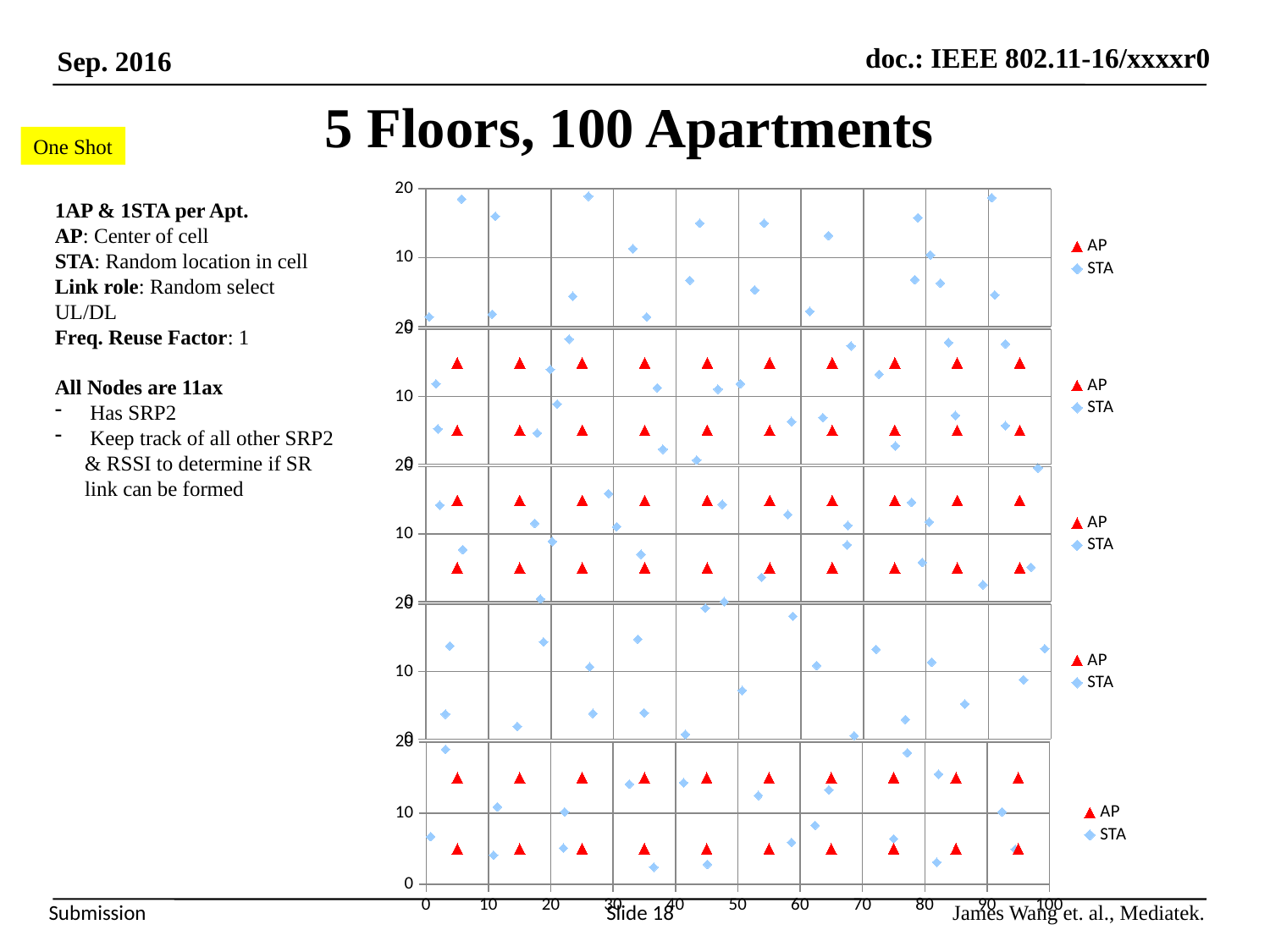
Which series is drawn with red triangle markers? AP In the middle chart, is the y value of the lower row of AP markers greater or less than 10? less What are the two series named in the legend of the top chart? AP and STA What kind of chart is used on this slide? scatter chart In the bottom chart, is the y value of the lower row of AP markers greater or less than 10? less In the bottom chart, is the y value of the upper row of AP markers greater or less than 10? greater How many series does the legend of the bottom chart list? 2